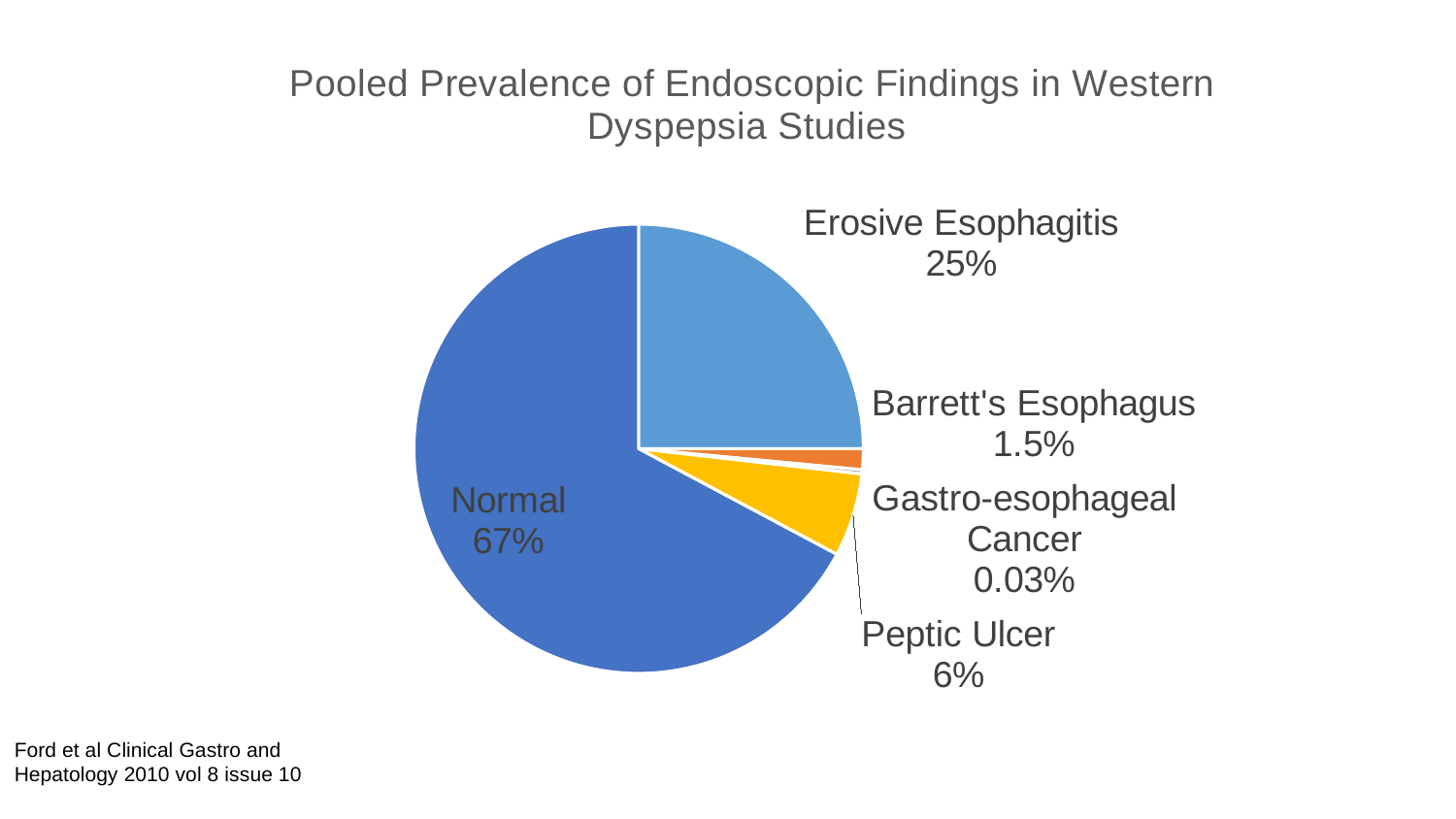
Which category has the smallest slice of the pie? Gastro-esophageal Cancer Which is larger, the Peptic Ulcer slice or the Barrett's Esophagus slice? Peptic Ulcer How many categories are shown in the pie chart? 5 Which category has the largest slice of the pie? Normal What is the value shown for Erosive Esophagitis? 25% What is the difference between the Normal and Erosive Esophagitis percentages? 42% What is the value shown for Peptic Ulcer? 6% What is the value shown for Gastro-esophageal Cancer? 0.03% What kind of chart is shown on the slide? pie chart What is the value shown for Barrett's Esophagus? 1.5% What is the title of the chart? Pooled Prevalence of Endoscopic Findings in Western Dyspepsia Studies What percentage of the pie is labelled Normal? 67%